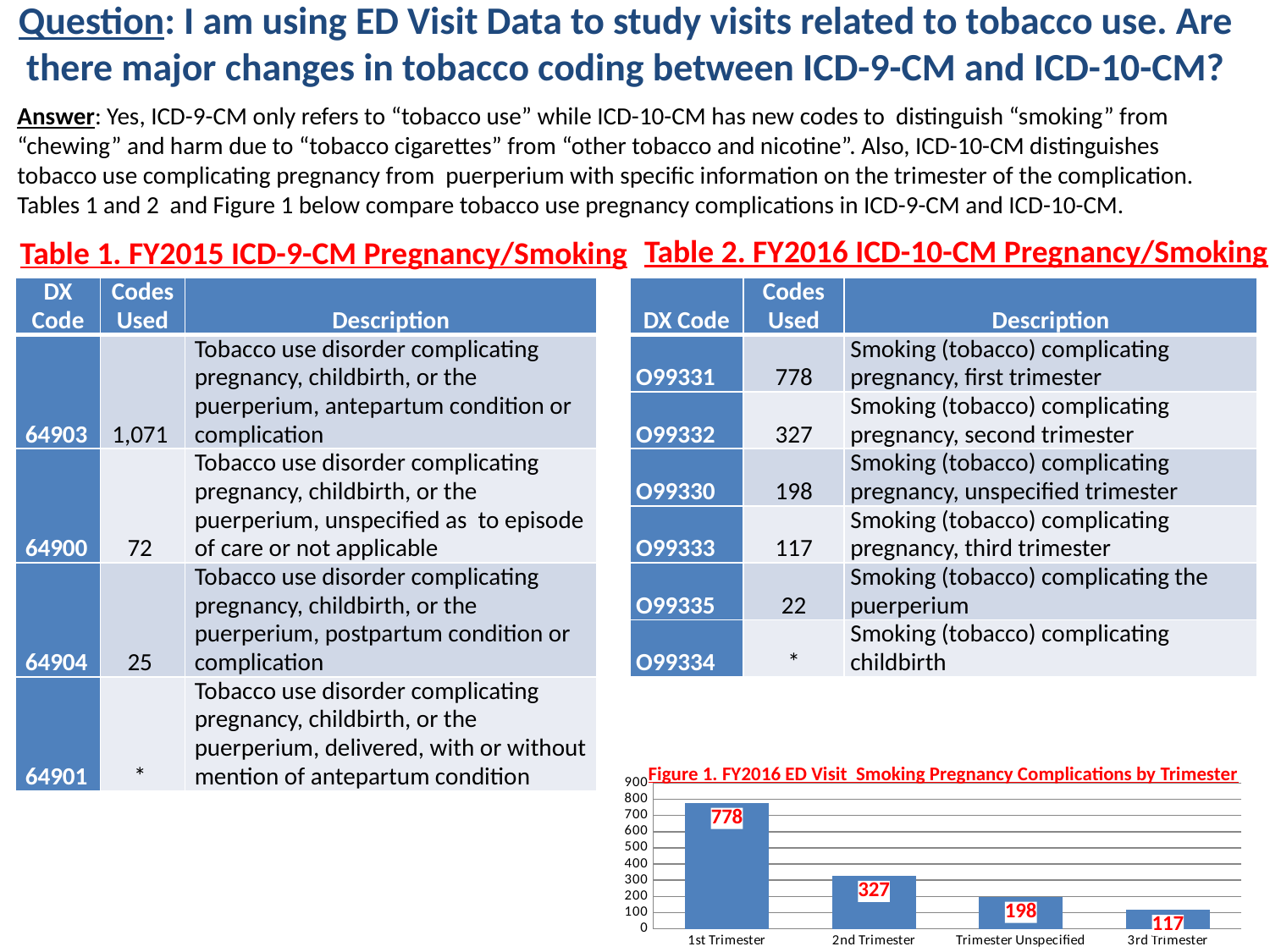
What is the value for 3rd Trimester in Figure 1? 117 What is the value for 1st Trimester in Figure 1? 778 What is the value for Trimester Unspecified in Figure 1? 198 What is the title of the chart on the slide? Figure 1. FY2016 ED Visit Smoking Pregnancy Complications by Trimester What is the difference between the 1st Trimester and 2nd Trimester values in Figure 1? 451 How many categories are shown in Figure 1? 4 Is the value for 2nd Trimester in Figure 1 greater or less than 400? less What is the value for 2nd Trimester in Figure 1? 327 Which category has the lowest value in Figure 1? 3rd Trimester In Figure 1, which is larger: Trimester Unspecified or 3rd Trimester? Trimester Unspecified Which category has the highest value in Figure 1? 1st Trimester What kind of chart is Figure 1? bar chart